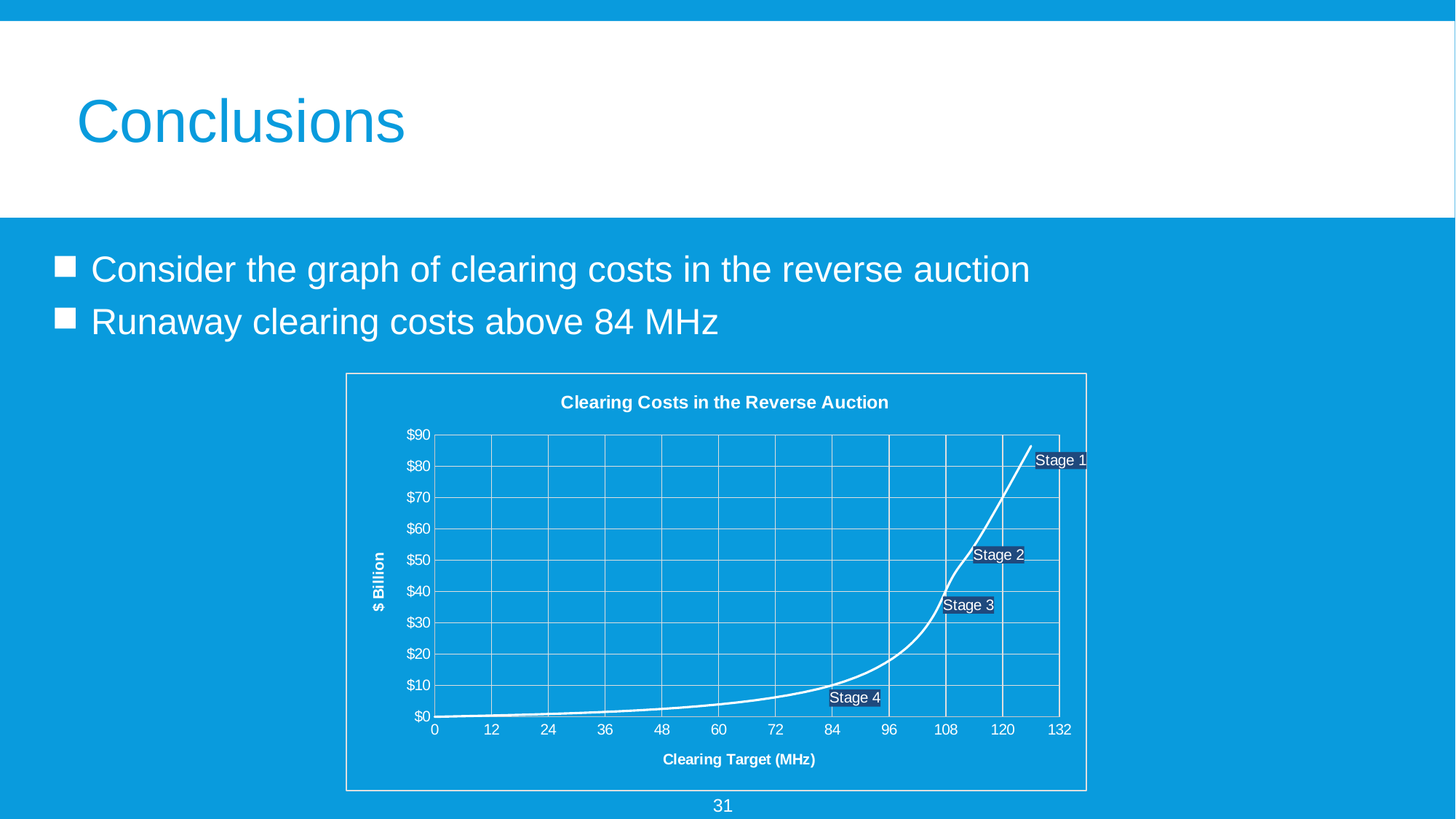
Is the clearing cost at the right-hand end of the curve greater or less than $80 billion? greater Is the clearing cost at a clearing target of 108 MHz greater or less than $30 billion? greater Do clearing costs rise or fall as the clearing target increases along the x axis? rise What kind of chart is shown on the slide? line chart Is the clearing cost at a clearing target of 48 MHz greater or less than $10 billion? less Which stage label is placed nearest the top of the curve, at the highest clearing cost? Stage 1 What is the label of the x axis of the chart? Clearing Target (MHz) What is the title of the chart? Clearing Costs in the Reverse Auction How many stage labels are annotated on the chart? 4